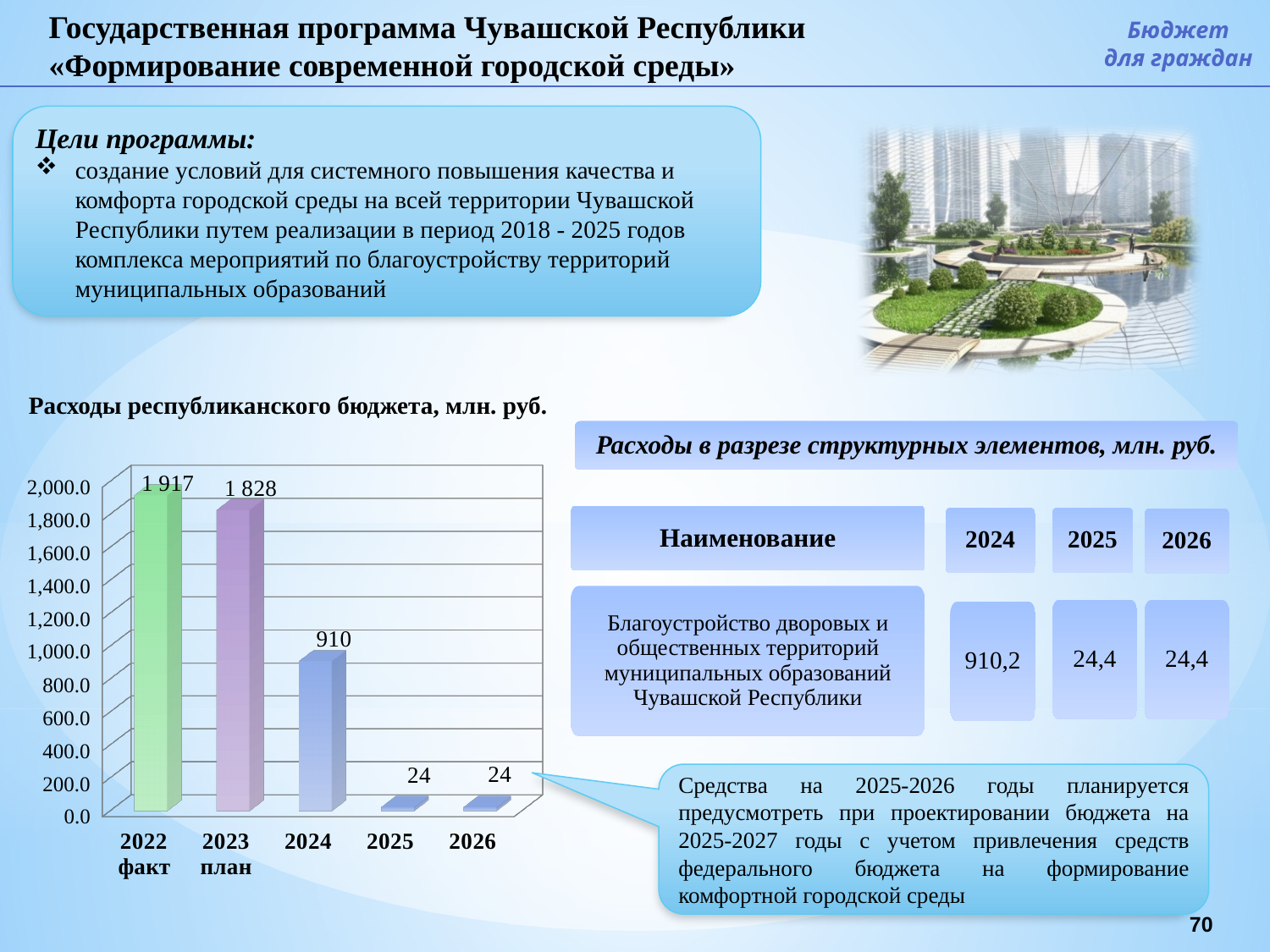
Is the value for 2024 in the chart 'Расходы республиканского бюджета, млн. руб.' greater or less than 1,000.0? less What is the value for 2023 план in the chart 'Расходы республиканского бюджета, млн. руб.'? 1 828 Do the values in the chart 'Расходы республиканского бюджета, млн. руб.' rise or fall from 2022 факт to 2026? fall What is the difference between the values for 2023 план and 2024 in the chart 'Расходы республиканского бюджета, млн. руб.'? 918 What is the value for 2026 in the chart 'Расходы республиканского бюджета, млн. руб.'? 24 What is the value for 2022 факт in the chart 'Расходы республиканского бюджета, млн. руб.'? 1 917 How many categories are shown on the x axis of the chart 'Расходы республиканского бюджета, млн. руб.'? 5 Which year has the highest value in the chart 'Расходы республиканского бюджета, млн. руб.'? 2022 факт What is the value for 2024 in the chart 'Расходы республиканского бюджета, млн. руб.'? 910 Which is larger in the chart 'Расходы республиканского бюджета, млн. руб.': the value for 2023 план or the value for 2024? 2023 план What kind of chart is 'Расходы республиканского бюджета, млн. руб.'? bar chart What is the difference between the values for 2022 факт and 2023 план in the chart 'Расходы республиканского бюджета, млн. руб.'? 89